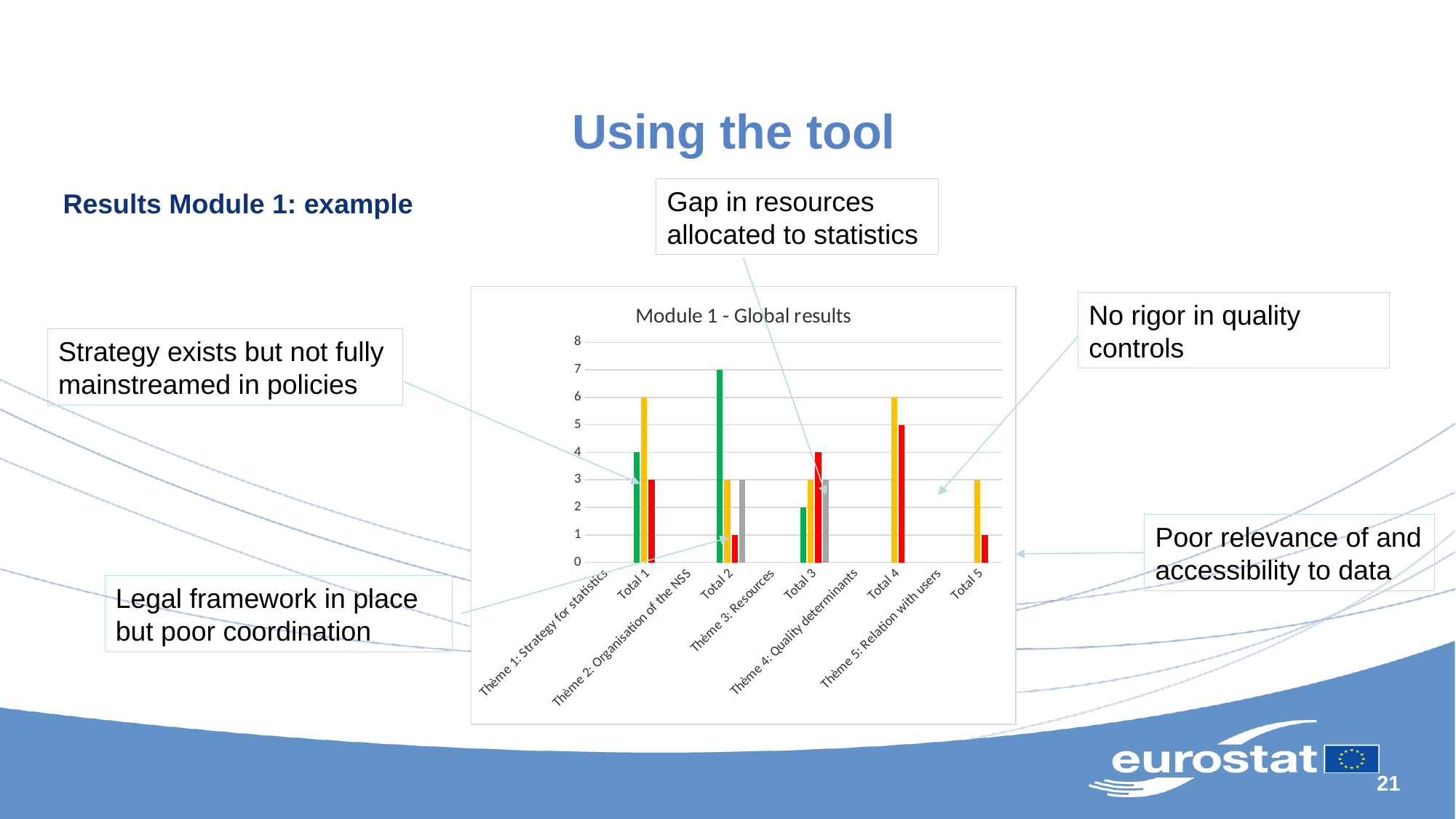
What is the highest value shown on the vertical axis of the chart? 8 Which category has the tallest bar in the chart? Total 2 Which is larger, the green bar for Total 1 or the green bar for Total 3? Total 1 What value does the yellow bar for Total 1 reach? 6 What value does the green bar for Total 2 reach? 7 Is the green bar for Total 3 greater or less than 3? less Is the red bar for Total 4 greater or less than 4? greater How many category labels are shown along the x axis of the chart? 10 What is the title of the chart? Module 1 - Global results Is the red bar for Total 5 greater or less than 2? less What kind of chart is shown on the slide? Bar chart Which is larger, the yellow bar for Total 4 or the yellow bar for Total 5? Total 4